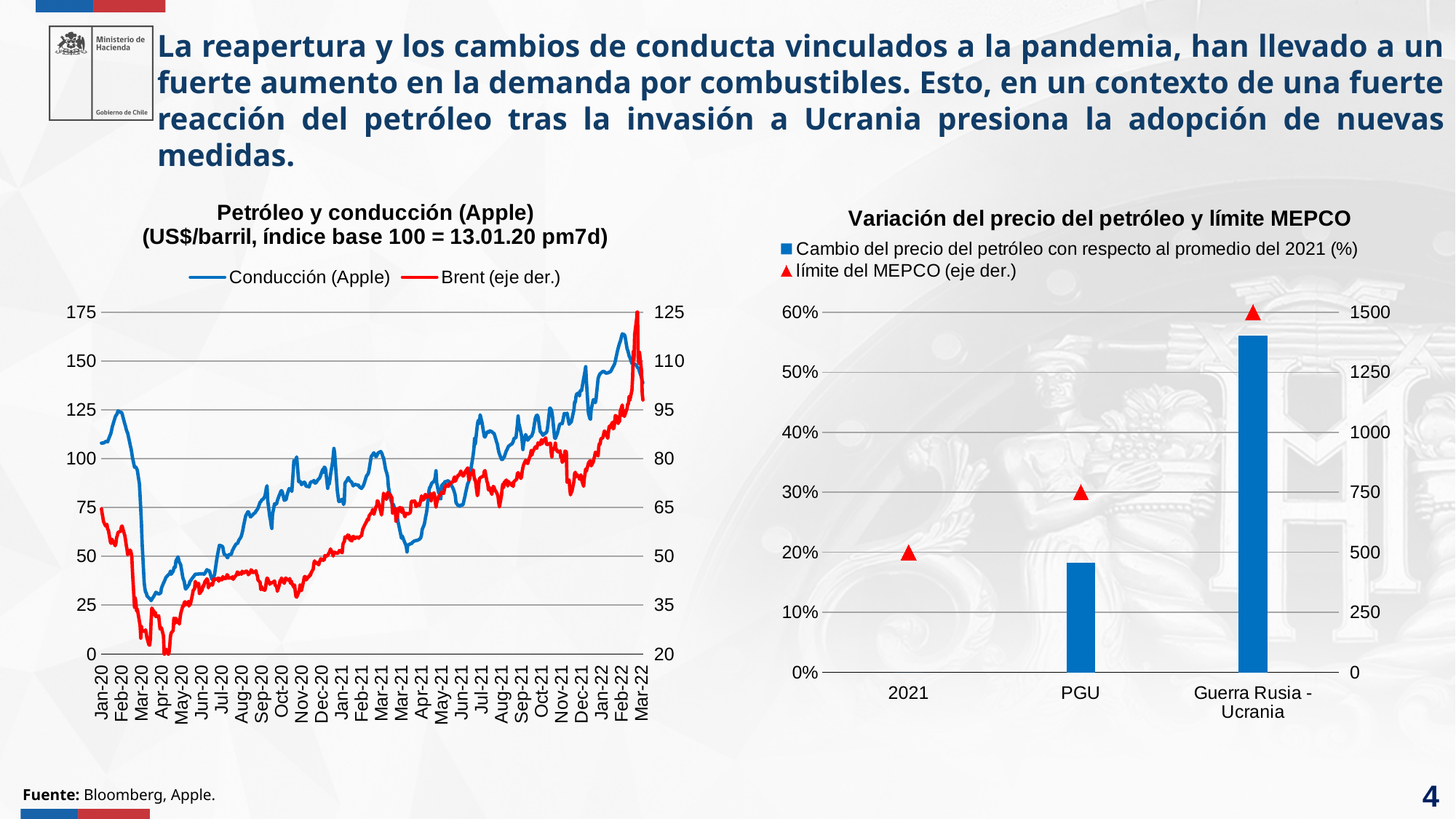
In the left chart, 'Petróleo y conducción (Apple)', which series is plotted on the right axis? Brent (eje der.) What kind of chart is the left chart, 'Petróleo y conducción (Apple)'? line chart What kind of chart is the right chart, 'Variación del precio del petróleo y límite MEPCO'? bar chart In the right chart, 'Variación del precio del petróleo y límite MEPCO', which category has the highest bar for the change in oil price? Guerra Rusia - Ucrania How many series does the legend of the right chart, 'Variación del precio del petróleo y límite MEPCO', list? 2 In the right chart, 'Variación del precio del petróleo y límite MEPCO', what is the límite del MEPCO value for PGU? 750 In the left chart, 'Petróleo y conducción (Apple)', does the Brent series overall rise or fall from Apr-20 to Feb-22? rise How many series does the legend of the left chart, 'Petróleo y conducción (Apple)', list? 2 In the right chart, 'Variación del precio del petróleo y límite MEPCO', what is the límite del MEPCO value for Guerra Rusia - Ucrania? 1500 In the left chart, 'Petróleo y conducción (Apple)', is the Brent value in Apr-20 greater or less than 35? less In the right chart, 'Variación del precio del petróleo y límite MEPCO', is the bar for PGU greater or less than 20%? less How many categories are shown on the x axis of the right chart, 'Variación del precio del petróleo y límite MEPCO'? 3